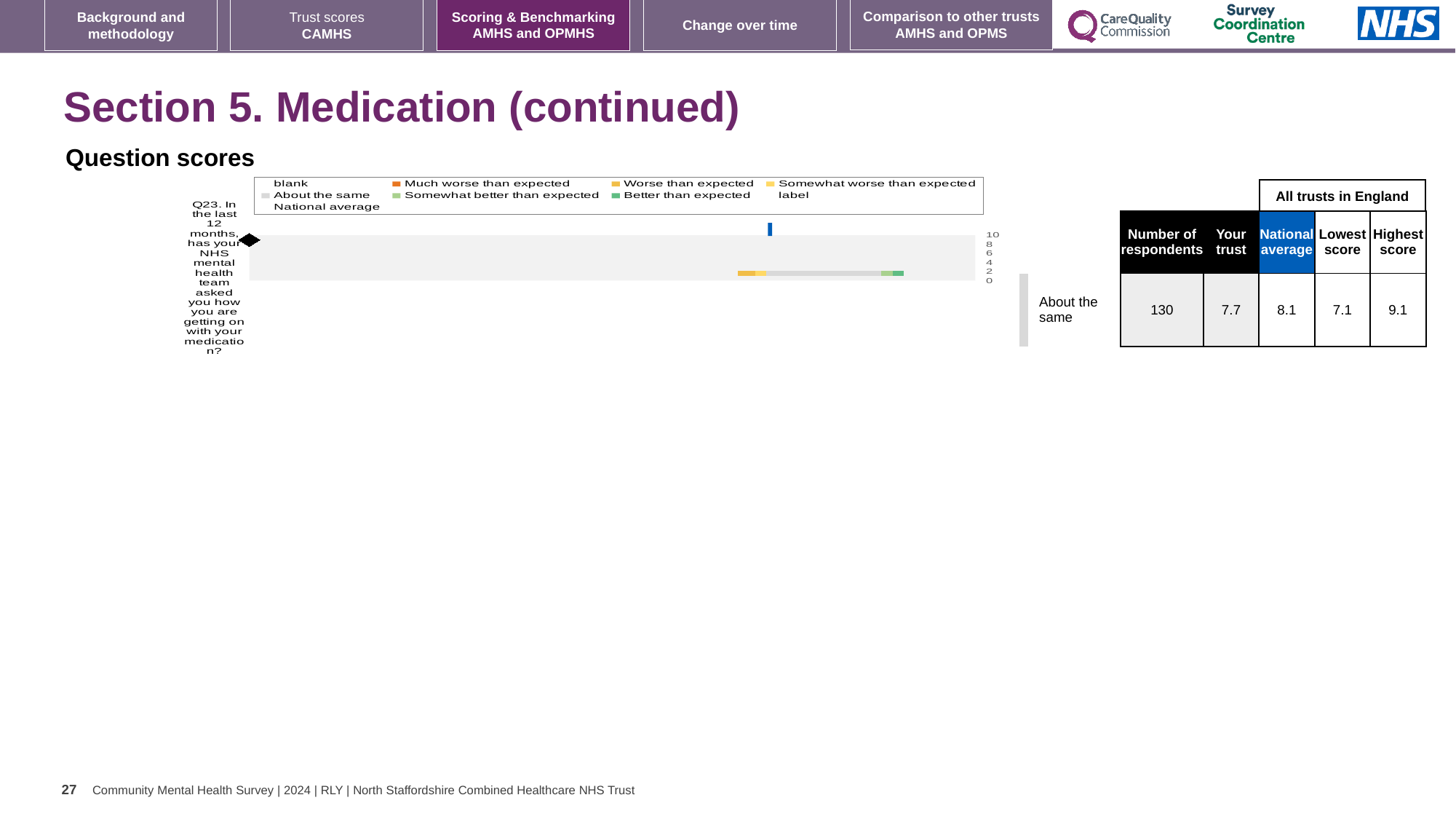
How many questions (categories) are plotted in the chart? 1 What is the difference between the highest score and the lowest score for Q23? 2.0 In the table beside the chart, what is the highest score among all trusts in England for Q23? 9.1 What benchmark category is shown for Q23 next to the chart? About the same In the table beside the chart, how many respondents answered Q23? 130 Which is larger for Q23, the 'Your trust' score or the national average? National average What kind of chart is shown under 'Question scores'? Bar chart In the table beside the chart, what is the 'Your trust' score for Q23? 7.7 In the table beside the chart, what is the national average for Q23? 8.1 How many entries does the chart's legend list? 9 In the table beside the chart, what is the lowest score among all trusts in England for Q23? 7.1 Which question number is plotted in the chart? Q23